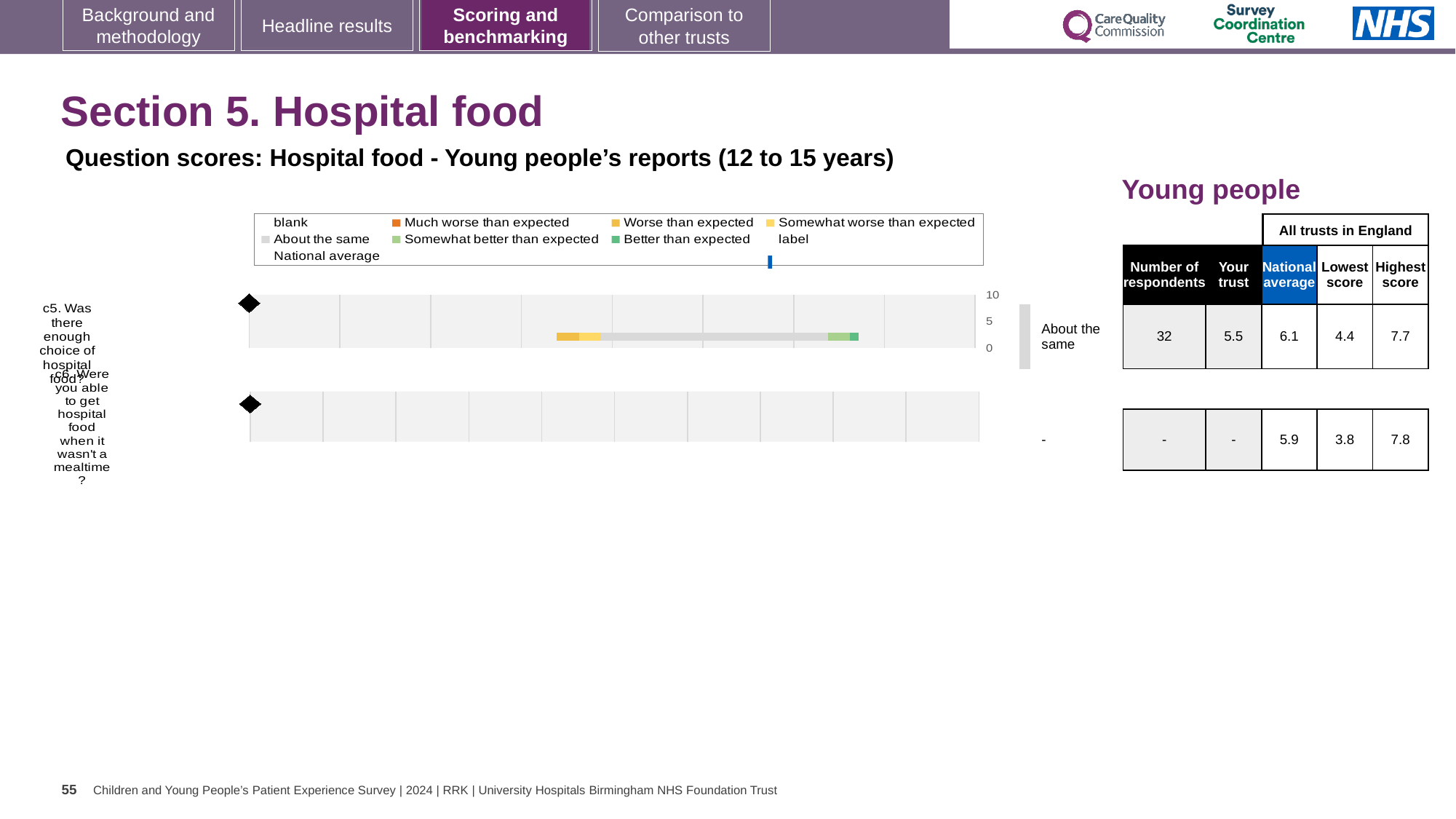
What kind of chart is used to show the question scores on this slide? bar chart What is the lowest score among all trusts in England for question c6? 3.8 What is the 'Your trust' score for question c5 (Was there enough choice of hospital food?)? 5.5 What is the national average score for question c6 (Were you able to get hospital food when it wasn't a mealtime?)? 5.9 What is the national average score for question c5? 6.1 How many survey questions (categories) are plotted in the chart? 2 What is the difference between the highest and lowest scores for question c5? 3.3 What benchmark category is shown next to the bar for question c5? About the same For question c5, which is larger: the trust's score or the national average? National average What is the highest score among all trusts in England for question c5? 7.7 What is the maximum value shown on the chart's score axis? 10 How many respondents answered question c5? 32